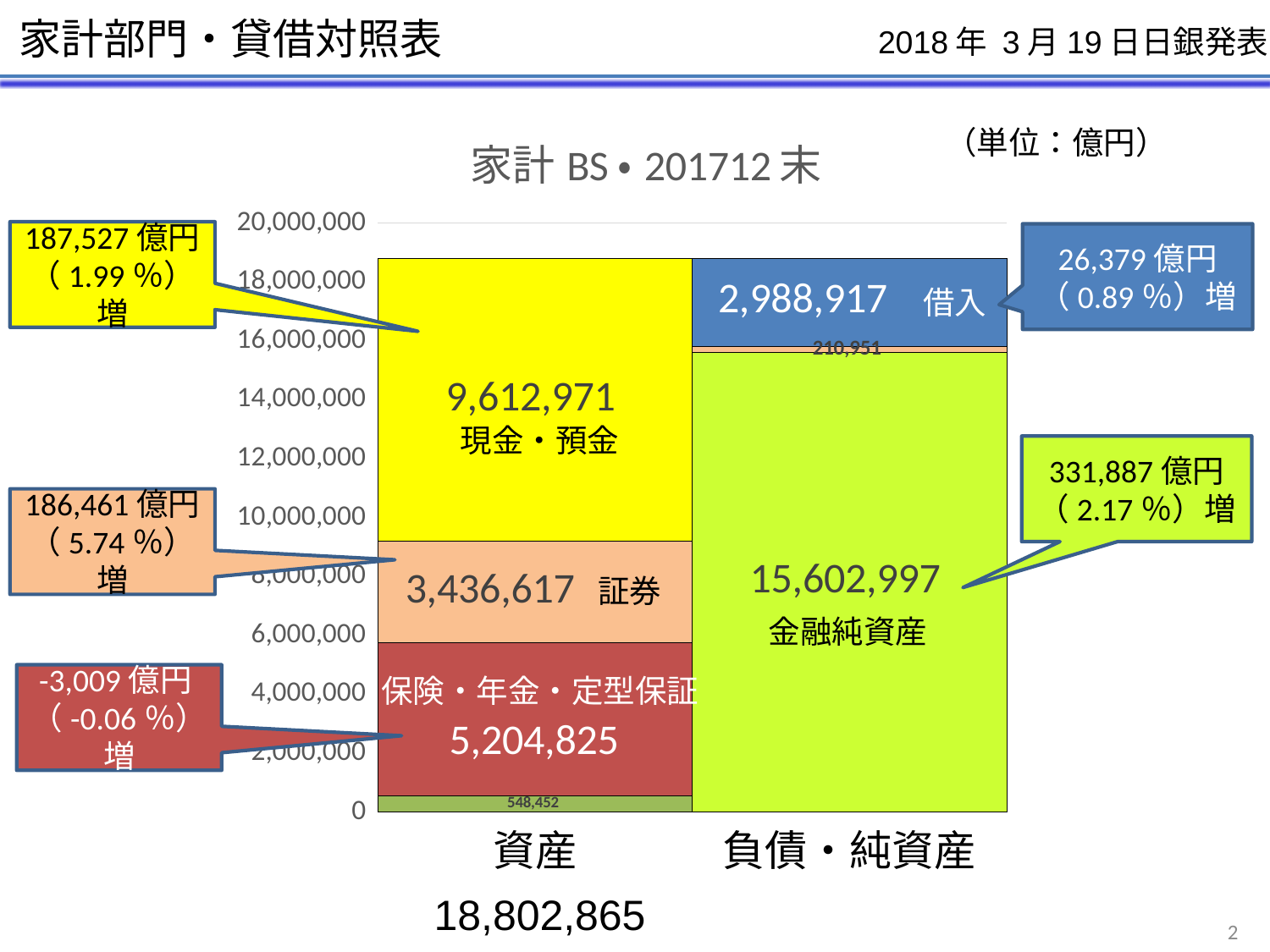
Which segment of the 資産 bar is the largest? 現金・預金 What is the difference between 現金・預金 and 証券 in the 資産 bar? 6,176,354 What is the value of the 証券 segment in the 資産 bar? 3,436,617 Which is larger, 金融純資産 or 借入? 金融純資産 Is the value of 金融純資産 greater or less than 14,000,000? greater What is the value of the 保険・年金・定型保証 segment in the 資産 bar? 5,204,825 What is the value of the 借入 segment in the 負債・純資産 bar? 2,988,917 What is the value of the 現金・預金 segment in the 資産 bar? 9,612,971 What is the total of the 資産 stacked bar? 18,802,865 What is the value of the 金融純資産 segment in the 負債・純資産 bar? 15,602,997 What kind of chart is shown on the slide? Stacked bar chart What is the title of the chart? 家計 BS・201712末